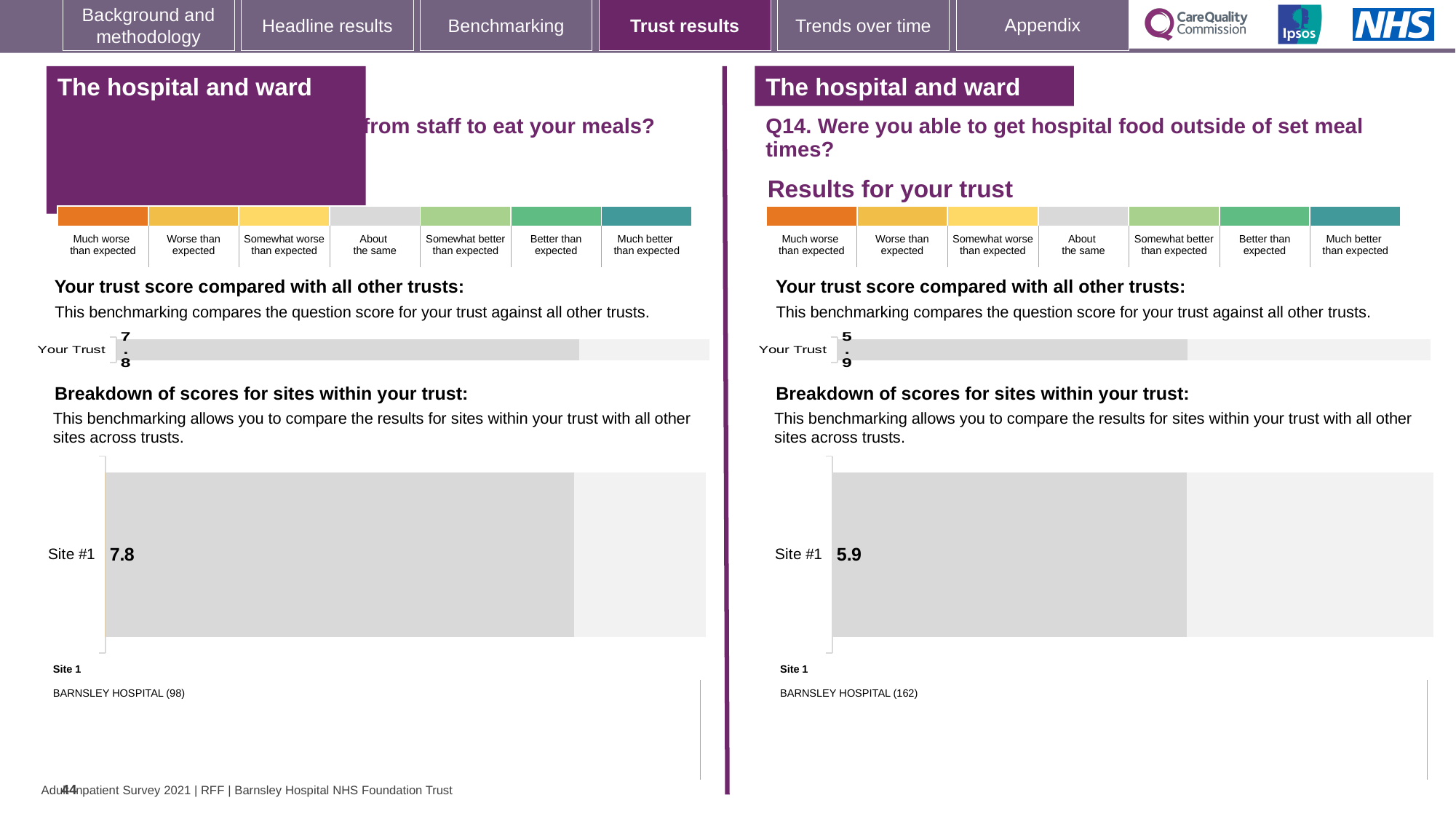
On the left-hand chart, what is the score shown for Your Trust? 7.8 What kind of chart is used to show the Your Trust score on the right-hand side? bar chart On the left-hand site breakdown chart, what is the score for Site #1? 7.8 Is the Your Trust score on the left-hand chart larger or smaller than the Your Trust score on the right-hand Q14 chart? larger On the right-hand side for Q14, what number appears in brackets after BARNSLEY HOSPITAL for Site 1? 162 On the right-hand chart for Q14, what is the score shown for Your Trust? 5.9 What is the difference between the Site #1 score on the left-hand chart and the Site #1 score on the right-hand Q14 chart? 1.9 On the left-hand side, what number appears in brackets after BARNSLEY HOSPITAL for Site 1? 98 How many sites are shown in the site breakdown chart on the right-hand side for Q14? 1 On the right-hand site breakdown chart for Q14, what is the score for Site #1? 5.9